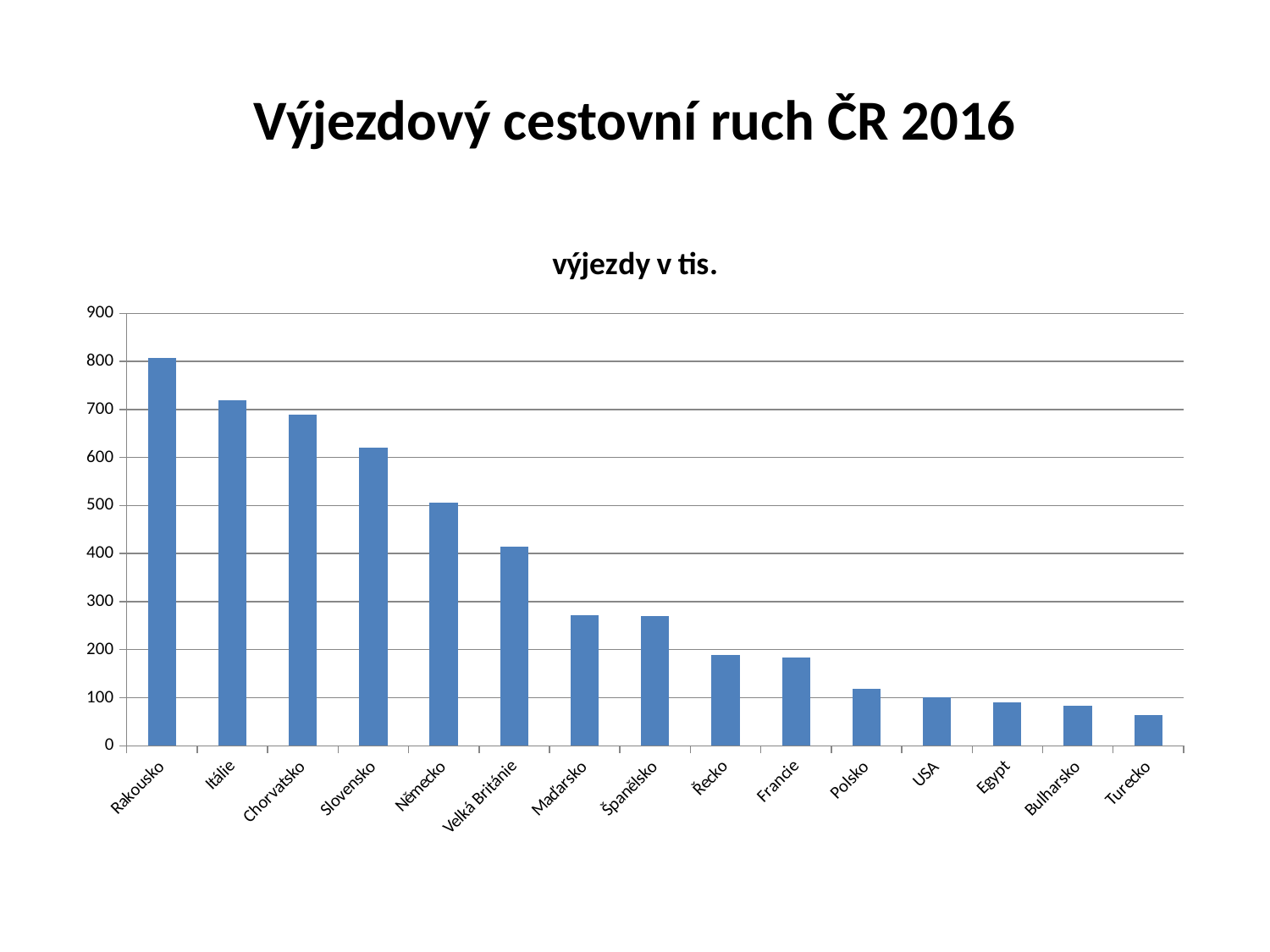
Which has a larger value, Chorvatsko or Slovensko? Chorvatsko Is the value for Turecko greater or less than 100? less Do the values rise or fall from left to right along the x axis? fall Which country has the highest value in the chart? Rakousko Is the value for Itálie greater or less than 700? greater Is the value for Německo greater or less than 600? less How many countries are shown on the x axis of the chart? 15 What type of chart is shown on the slide? bar chart What is the title printed above the chart's plot area? výjezdy v tis. Which country has the lowest value in the chart? Turecko